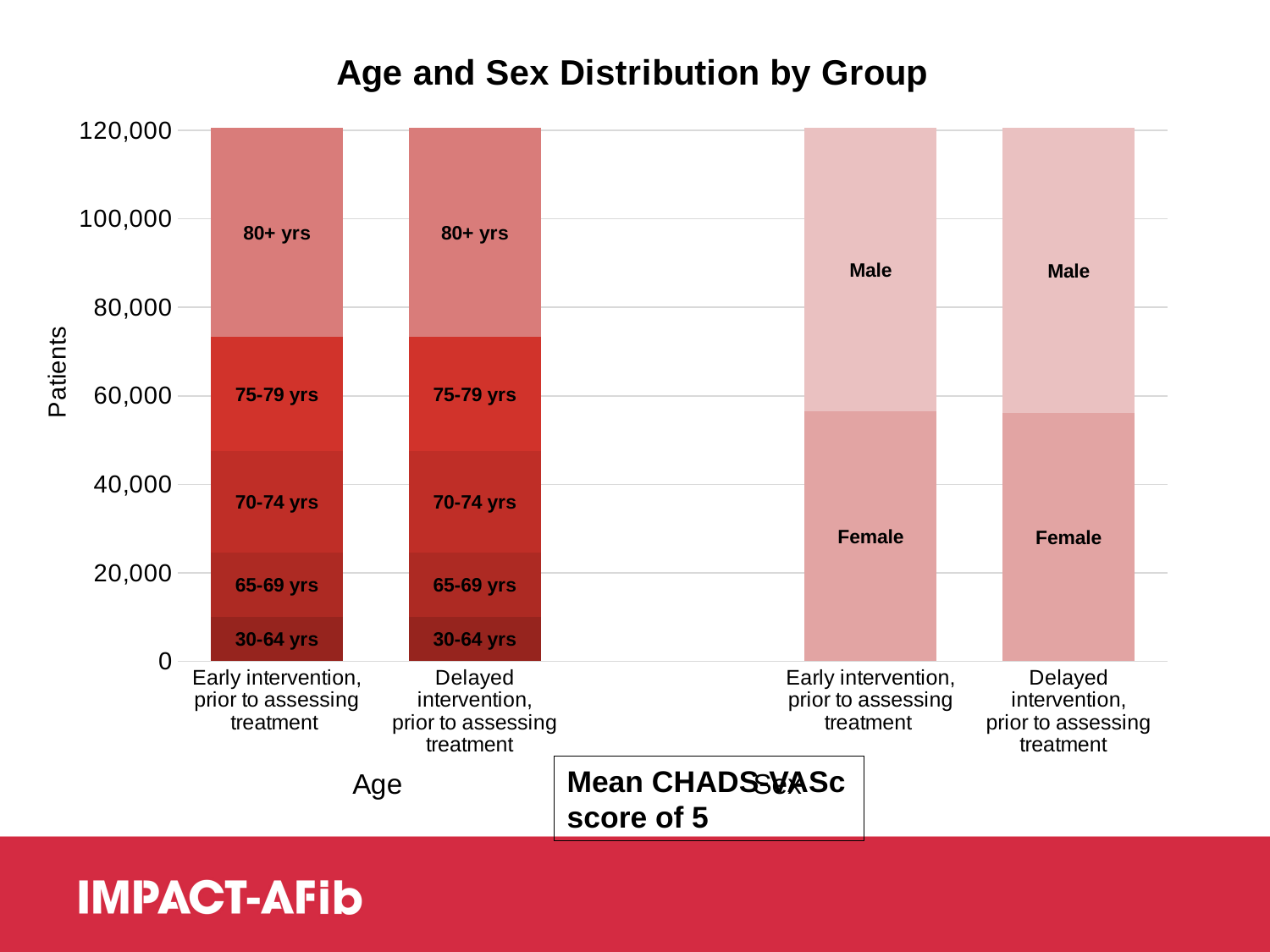
In the Age section's 'Delayed intervention, prior to assessing treatment' bar, is the 80+ yrs segment greater or less than 20,000 patients? greater How many age-group segments are stacked in the 'Early intervention, prior to assessing treatment' bar under Age? 5 In the Age section, which age-group segment is the smallest in the 'Delayed intervention, prior to assessing treatment' bar? 30-64 yrs In the Age section, which age-group segment is the largest in the 'Early intervention, prior to assessing treatment' bar? 80+ yrs How many stacked bars are plotted in the chart in total? 4 In the Age section's 'Early intervention, prior to assessing treatment' bar, is the 30-64 yrs segment greater or less than 20,000 patients? less What is the label on the vertical axis of the chart? Patients In the Sex section's 'Early intervention, prior to assessing treatment' bar, is the Female segment greater or less than 40,000 patients? greater What is the highest value shown on the vertical axis of the chart? 120,000 What kind of chart is shown on the slide? Stacked bar chart In the Age section's 'Early intervention, prior to assessing treatment' bar, which segment is larger: 80+ yrs or 30-64 yrs? 80+ yrs What is the title of the chart? Age and Sex Distribution by Group